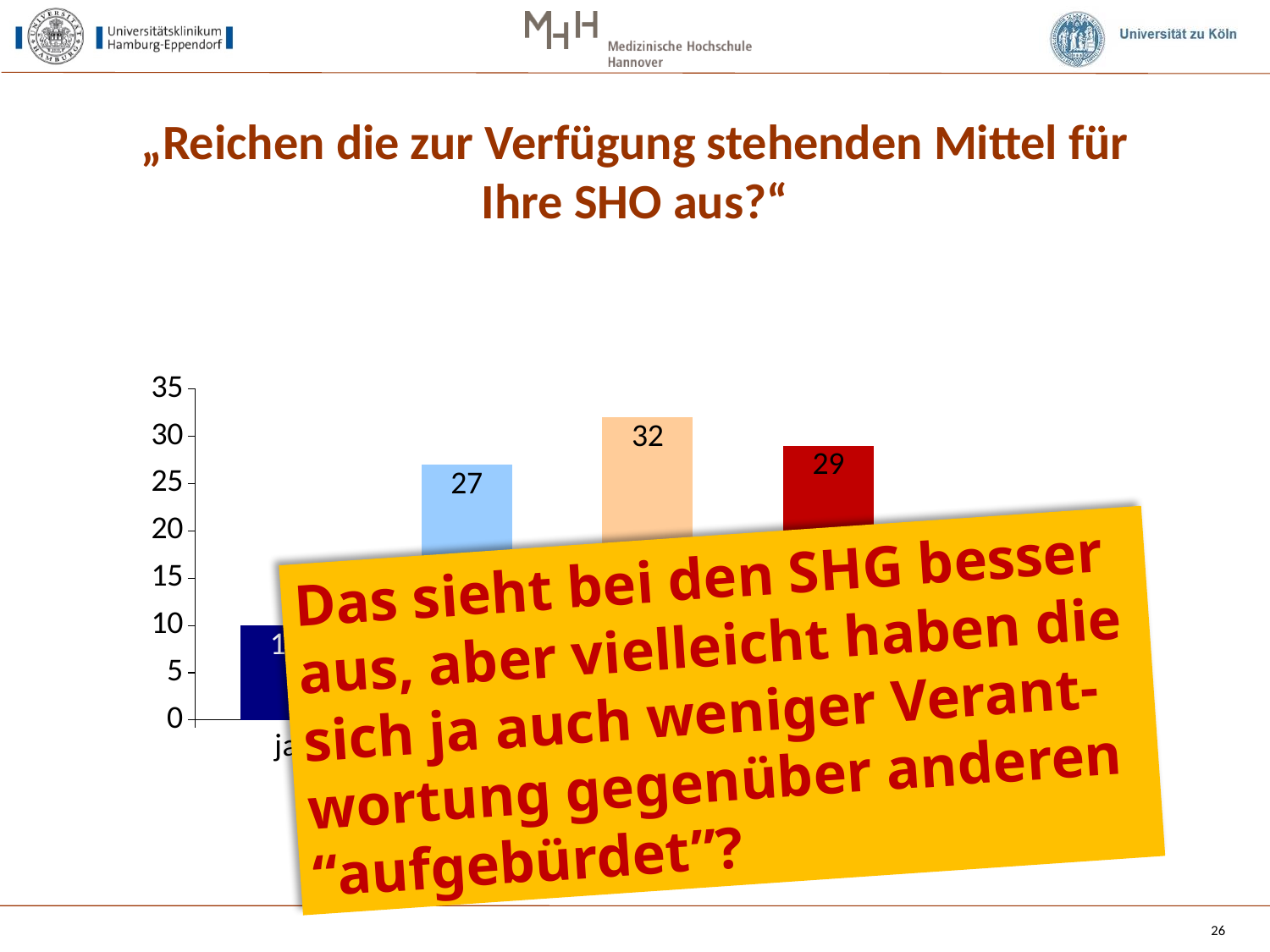
Is the value of the dark blue bar (leftmost) greater or less than 15? less What is the highest value shown by a data label in the chart? 32 What kind of chart is shown on the slide? bar chart Which is larger, the value of the dark red bar or the value of the light blue bar? the dark red bar What is the difference between the peach bar (32) and the light blue bar (27)? 5 What is the value of the peach-coloured bar (third from the left)? 32 What is the maximum value shown on the vertical axis? 35 What is the value of the light blue bar (second from the left)? 27 What is the difference between the dark red bar (29) and the light blue bar (27)? 2 What colour is the tallest bar in the chart? peach (light orange) What is the value of the dark red bar (rightmost)? 29